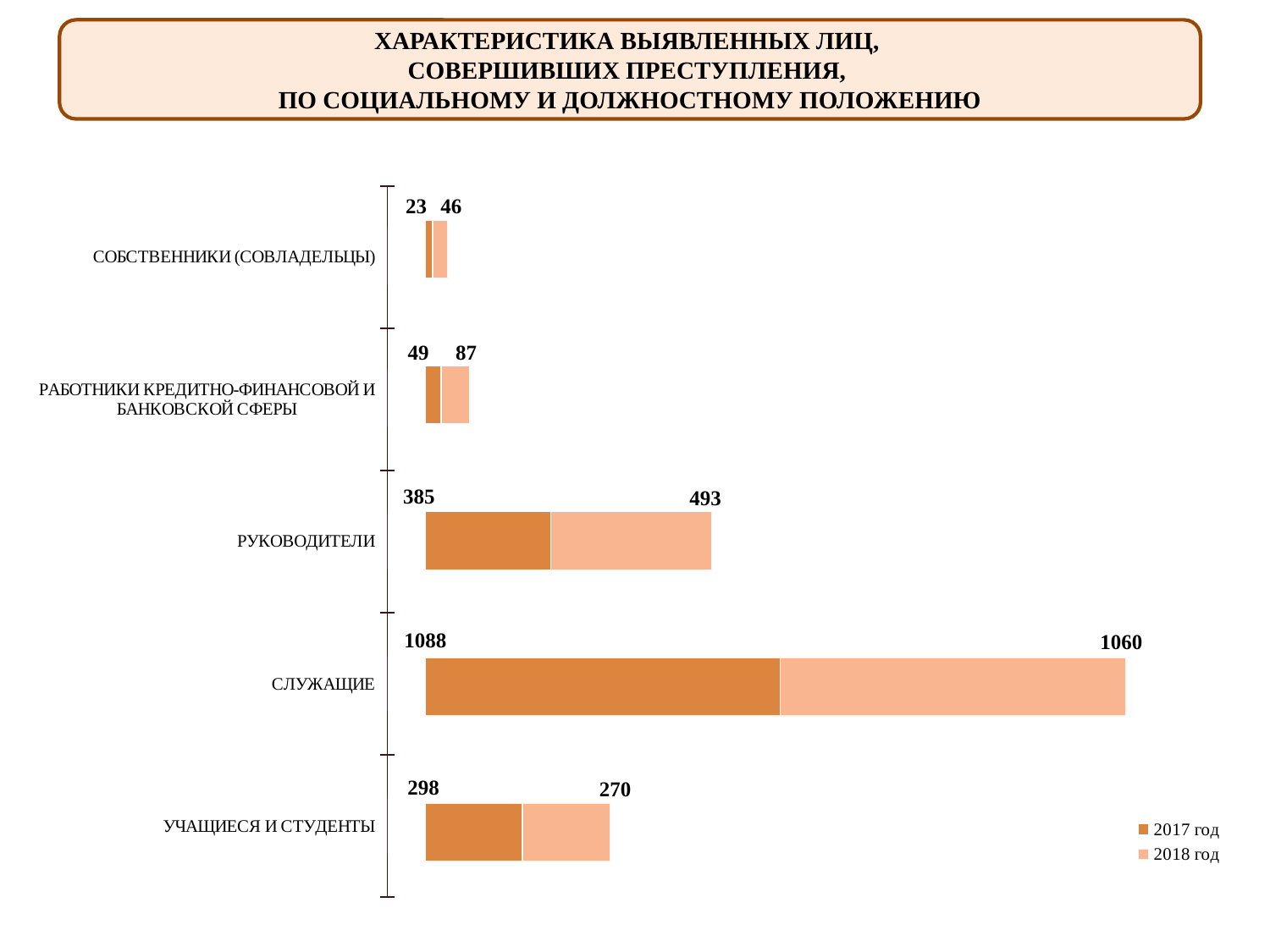
What is the value for РУКОВОДИТЕЛИ in the 2018 год series? 493 What is the difference between the 2018 год and 2017 год values for РУКОВОДИТЕЛИ? 108 What kind of chart is shown on the slide? Stacked bar chart What is the value for УЧАЩИЕСЯ И СТУДЕНТЫ in the 2017 год series? 298 Which is larger for УЧАЩИЕСЯ И СТУДЕНТЫ: the 2017 год value or the 2018 год value? 2017 год What is the total of the stacked bar for РАБОТНИКИ КРЕДИТНО-ФИНАНСОВОЙ И БАНКОВСКОЙ СФЕРЫ? 136 Which category has the highest value in the 2017 год series? СЛУЖАЩИЕ How many series does the legend list? 2 What is the value for СОБСТВЕННИКИ (СОВЛАДЕЛЬЦЫ) in the 2018 год series? 46 What is the value for СЛУЖАЩИЕ in the 2017 год series? 1088 Which category has the lowest value in the 2018 год series? СОБСТВЕННИКИ (СОВЛАДЕЛЬЦЫ) How many categories are shown on the chart? 5